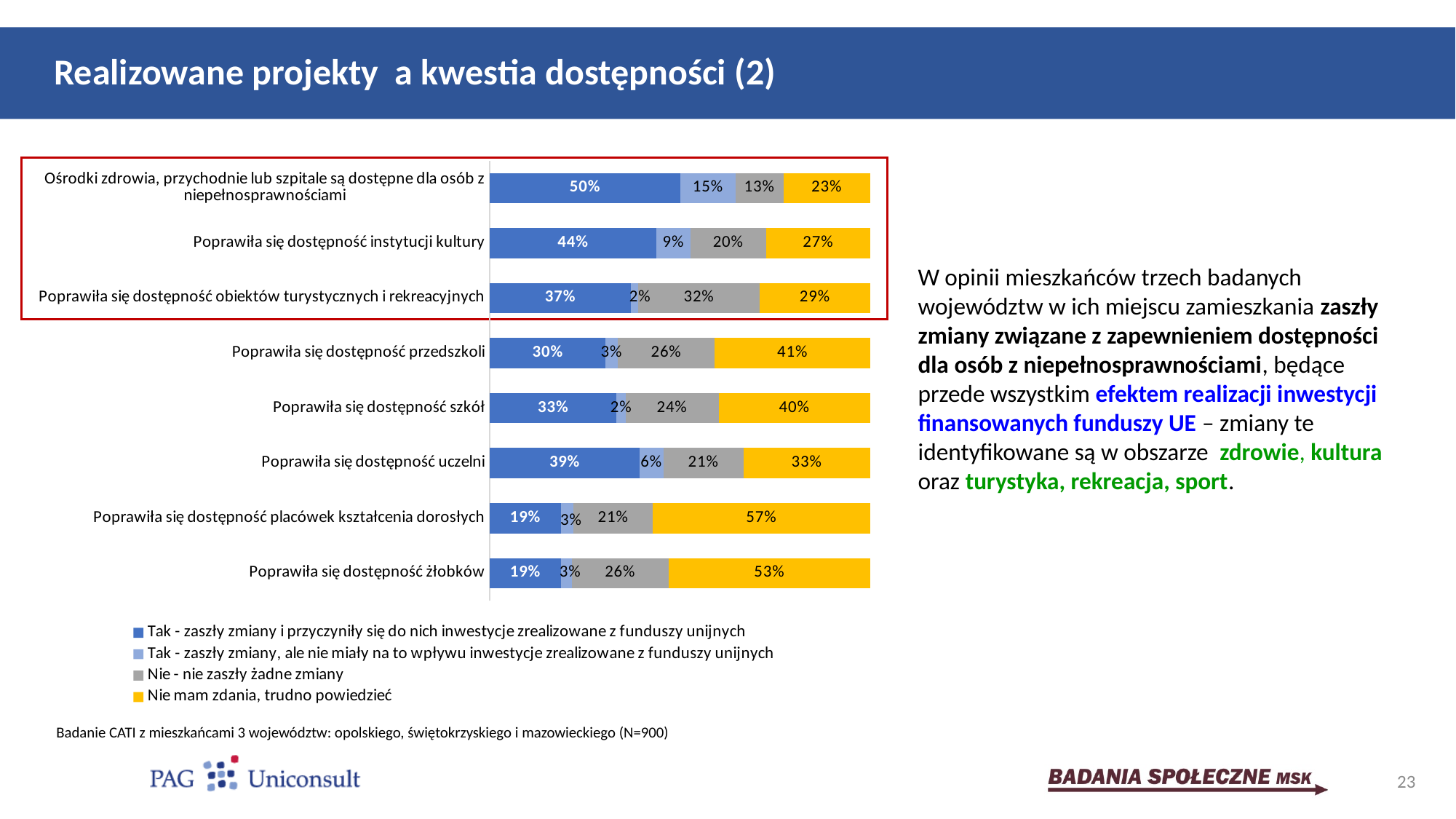
How many series does the legend list? 4 What colour represents the series 'Nie mam zdania, trudno powiedzieć' in the chart? Yellow Which category has the highest value for 'Tak - zaszły zmiany i przyczyniły się do nich inwestycje zrealizowane z funduszy unijnych'? Ośrodki zdrowia, przychodnie lub szpitale są dostępne dla osób z niepełnosprawnościami Which category has the lowest value for 'Nie mam zdania, trudno powiedzieć'? Ośrodki zdrowia, przychodnie lub szpitale są dostępne dla osób z niepełnosprawnościami What is the value of 'Tak - zaszły zmiany i przyczyniły się do nich inwestycje zrealizowane z funduszy unijnych' for 'Poprawiła się dostępność instytucji kultury'? 44% What is the value of 'Nie mam zdania, trudno powiedzieć' for 'Poprawiła się dostępność placówek kształcenia dorosłych'? 57% How many categories (statements) are plotted in the chart? 8 What is the value of 'Nie - nie zaszły żadne zmiany' for 'Poprawiła się dostępność obiektów turystycznych i rekreacyjnych'? 32% What kind of chart is shown on the slide? Stacked bar chart What is the value of 'Tak - zaszły zmiany, ale nie miały na to wpływu inwestycje zrealizowane z funduszy unijnych' for 'Ośrodki zdrowia, przychodnie lub szpitale są dostępne dla osób z niepełnosprawnościami'? 15% Which is larger: the 'Tak - zaszły zmiany i przyczyniły się do nich inwestycje zrealizowane z funduszy unijnych' value for 'Poprawiła się dostępność szkół' or for 'Poprawiła się dostępność uczelni'? Poprawiła się dostępność uczelni What is the difference between the 'Nie mam zdania, trudno powiedzieć' values for 'Poprawiła się dostępność żłobków' and 'Poprawiła się dostępność uczelni'? 20%